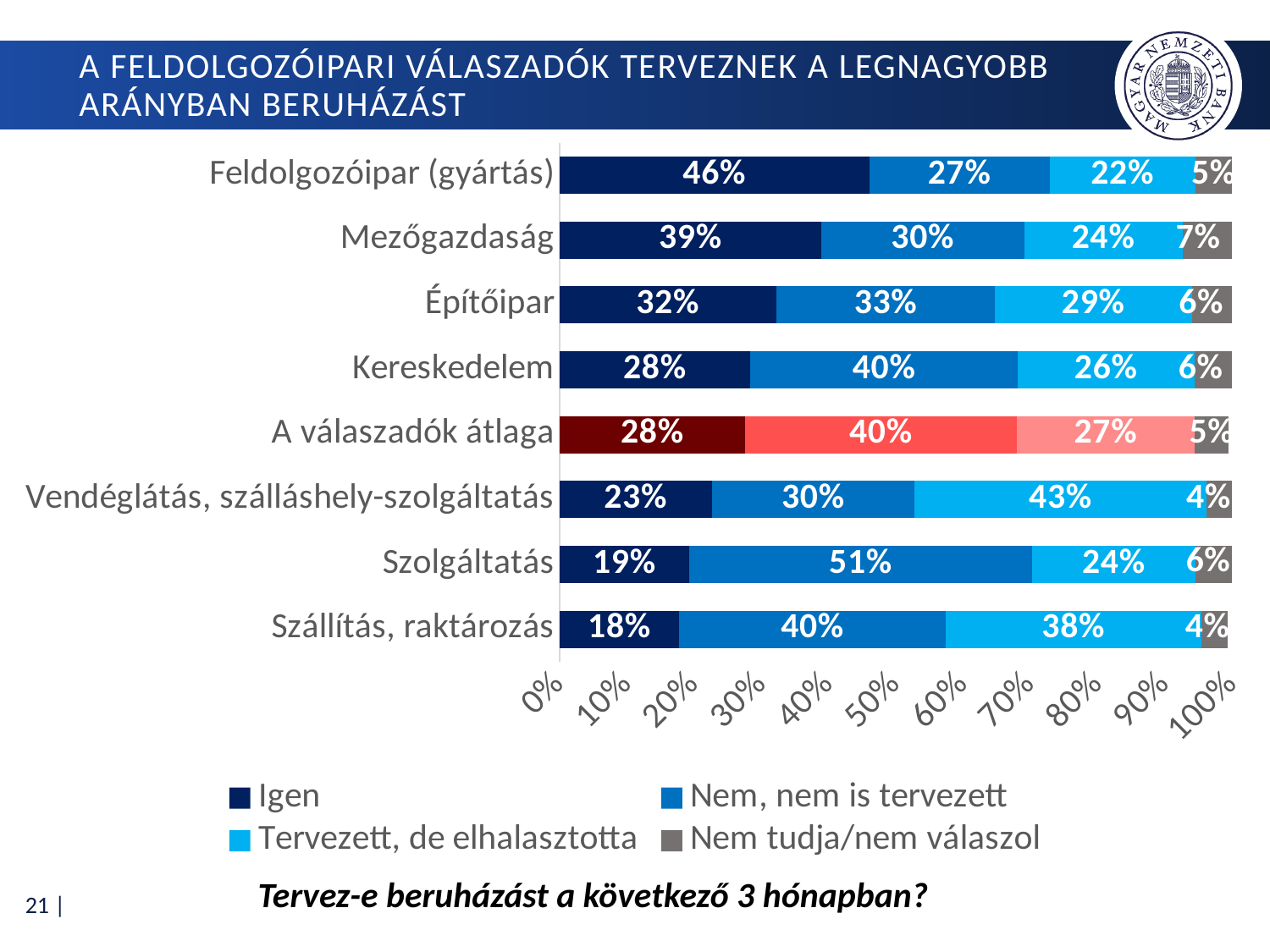
What is the 'Igen' value for Feldolgozóipar (gyártás)? 46% What is the 'Nem tudja/nem válaszol' value for Mezőgazdaság? 7% Which is larger: the 'Tervezett, de elhalasztotta' value for Szállítás, raktározás or for Építőipar? Szállítás, raktározás How many series does the legend list? 4 What is the 'Tervezett, de elhalasztotta' value for Vendéglátás, szálláshely-szolgáltatás? 43% Which category has the lowest 'Igen' value? Szállítás, raktározás How many categories are shown on the chart? 8 What is the difference between the 'Igen' values for Feldolgozóipar (gyártás) and Mezőgazdaság? 7% What is the 'Igen' value for A válaszadók átlaga? 28% What is the 'Nem, nem is tervezett' value for Szolgáltatás? 51% What kind of chart is shown on the slide? Stacked bar chart Which category has the highest 'Igen' value? Feldolgozóipar (gyártás)